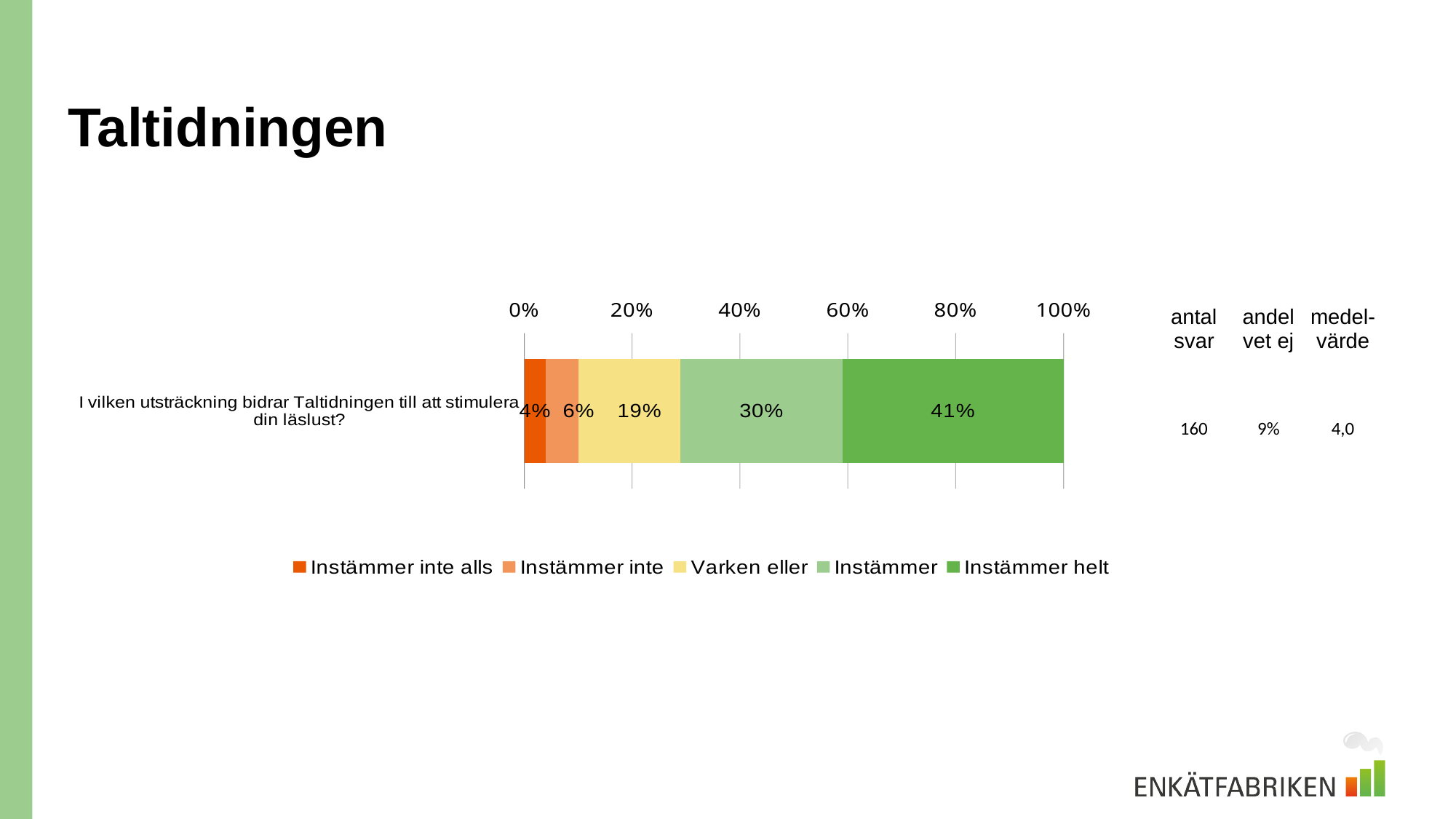
Which response category has the largest share in the bar? Instämmer helt Which response category has the smallest share in the bar? Instämmer inte alls What kind of chart is shown on the slide? Stacked bar chart What is the title of the slide? Taltidningen What percentage of respondents answered "Instämmer helt" to the question about Taltidningen stimulating reading desire? 41% What percentage of respondents answered "Varken eller"? 19% What percentage of respondents answered "Instämmer"? 30% What is the total of the "Instämmer" and "Instämmer helt" segments combined? 71% How many response categories does the legend list? 5 What percentage of respondents answered "Instämmer inte alls"? 4% What is the difference in percentage points between "Instämmer helt" and "Instämmer"? 11 Which is larger, the share for "Varken eller" or the share for "Instämmer inte"? Varken eller